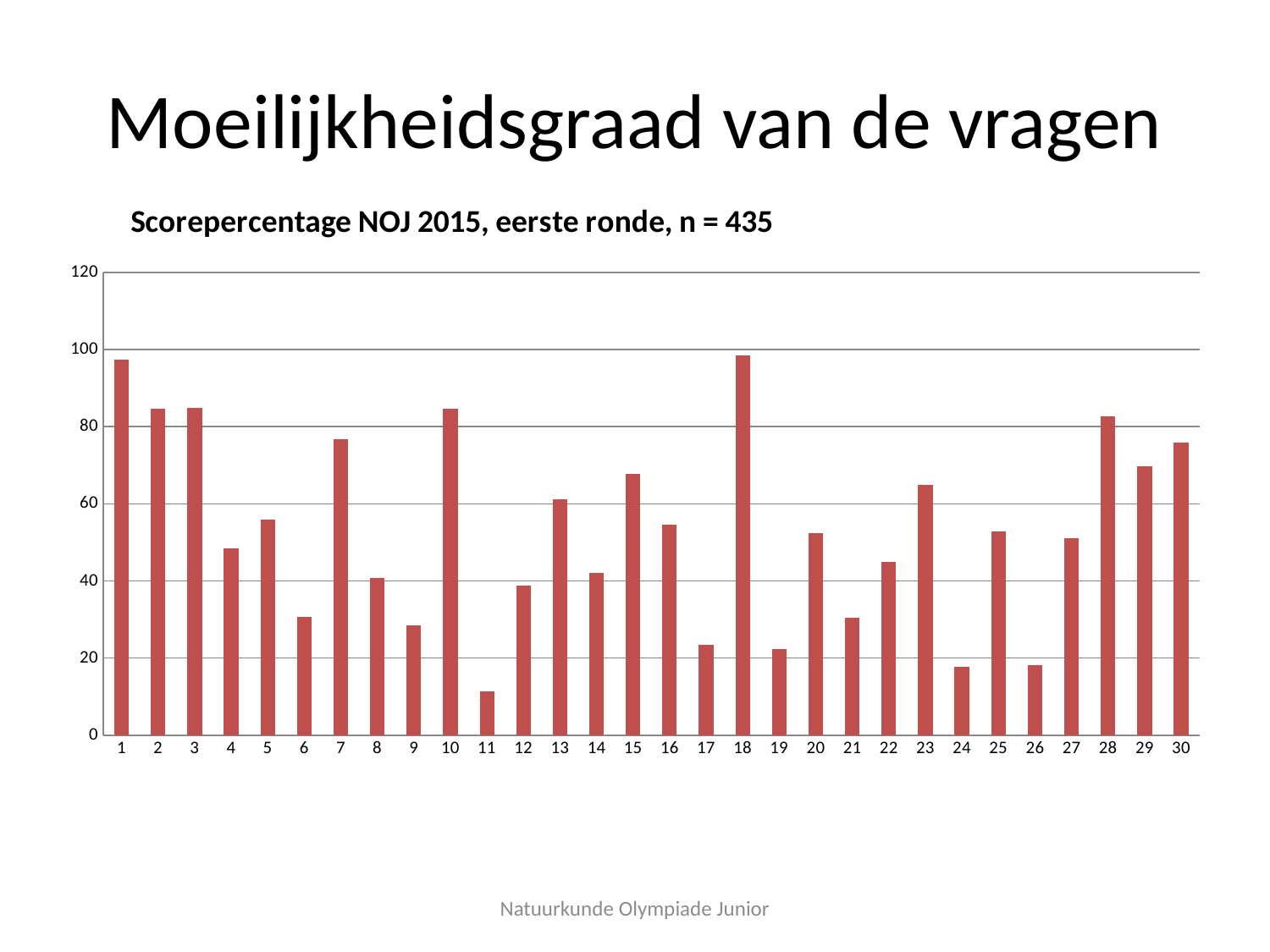
What is the title of the chart? Scorepercentage NOJ 2015, eerste ronde, n = 435 Which has the higher value, question 15 or question 16? 15 Which has the higher value, question 7 or question 8? 7 Which has the higher value, question 5 or question 6? 5 Is the value for question 7 greater or less than 60? greater Is the value for question 1 greater or less than 80? greater Is the value for question 9 greater or less than 40? less How many questions (categories) are plotted on the x axis? 30 Which question has the lowest score percentage? 11 What kind of chart is shown on the slide? bar chart